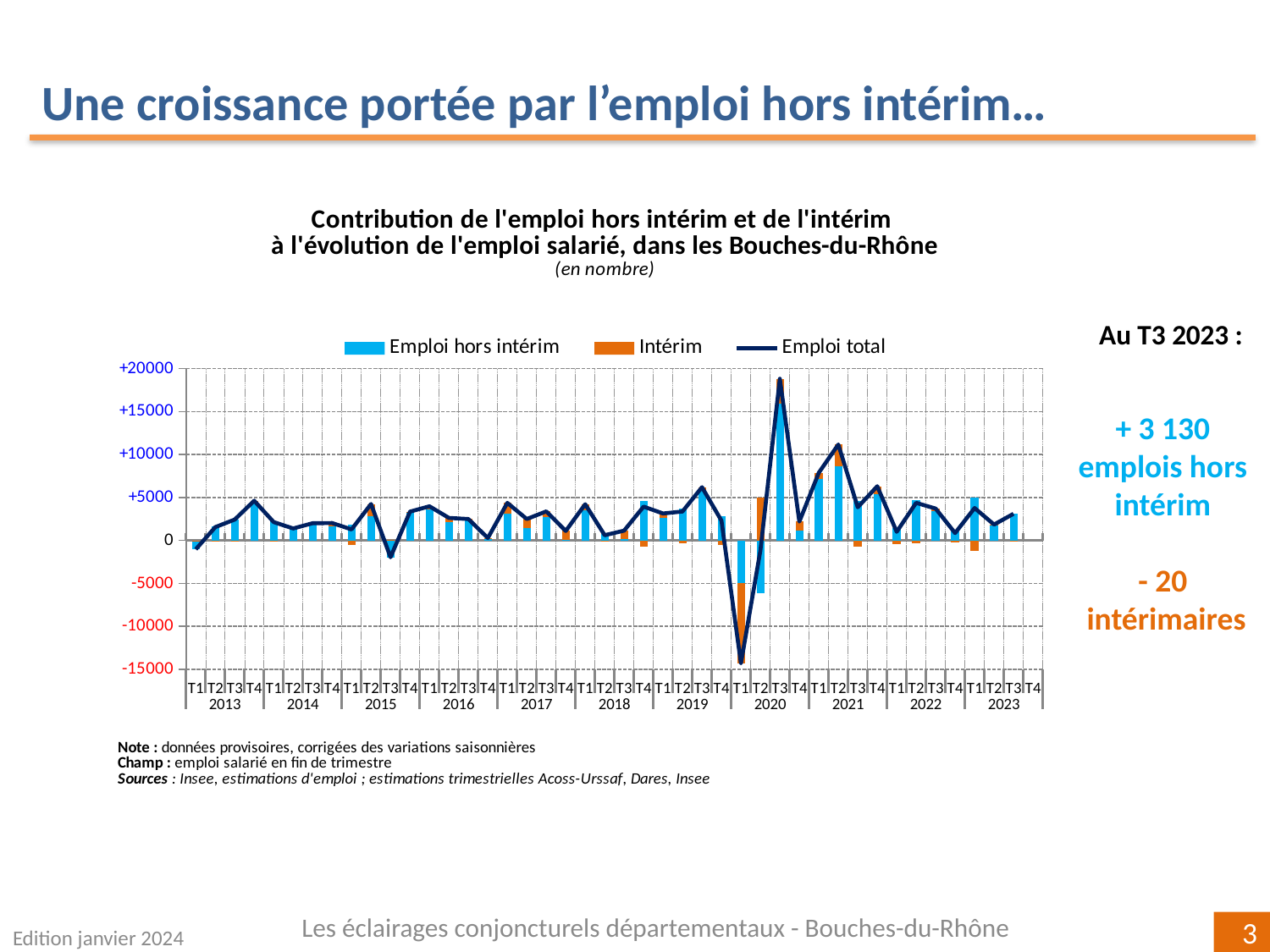
Is the value of Emploi total at T1 2020 greater or less than -10000? less What are the three series listed in the chart legend? Emploi hors intérim, Intérim, Emploi total According to the slide, what is the value for Intérim at T3 2023? - 20 According to the slide, what is the value for Emploi hors intérim at T3 2023? + 3 130 Is the value of Emploi hors intérim at T2 2021 greater or less than 5000? greater What kind of chart is shown on the slide? A combined bar and line chart Is the value of Emploi total at T3 2020 greater or less than 15000? greater Which is larger, the Emploi total value at T3 2020 or at T2 2021? T3 2020 In which quarter does the Emploi total line reach its highest value? T3 2020 In which quarter does the Emploi total line reach its lowest value? T1 2020 Which colour represents the Intérim series in the chart? Orange How many series does the chart legend list? 3